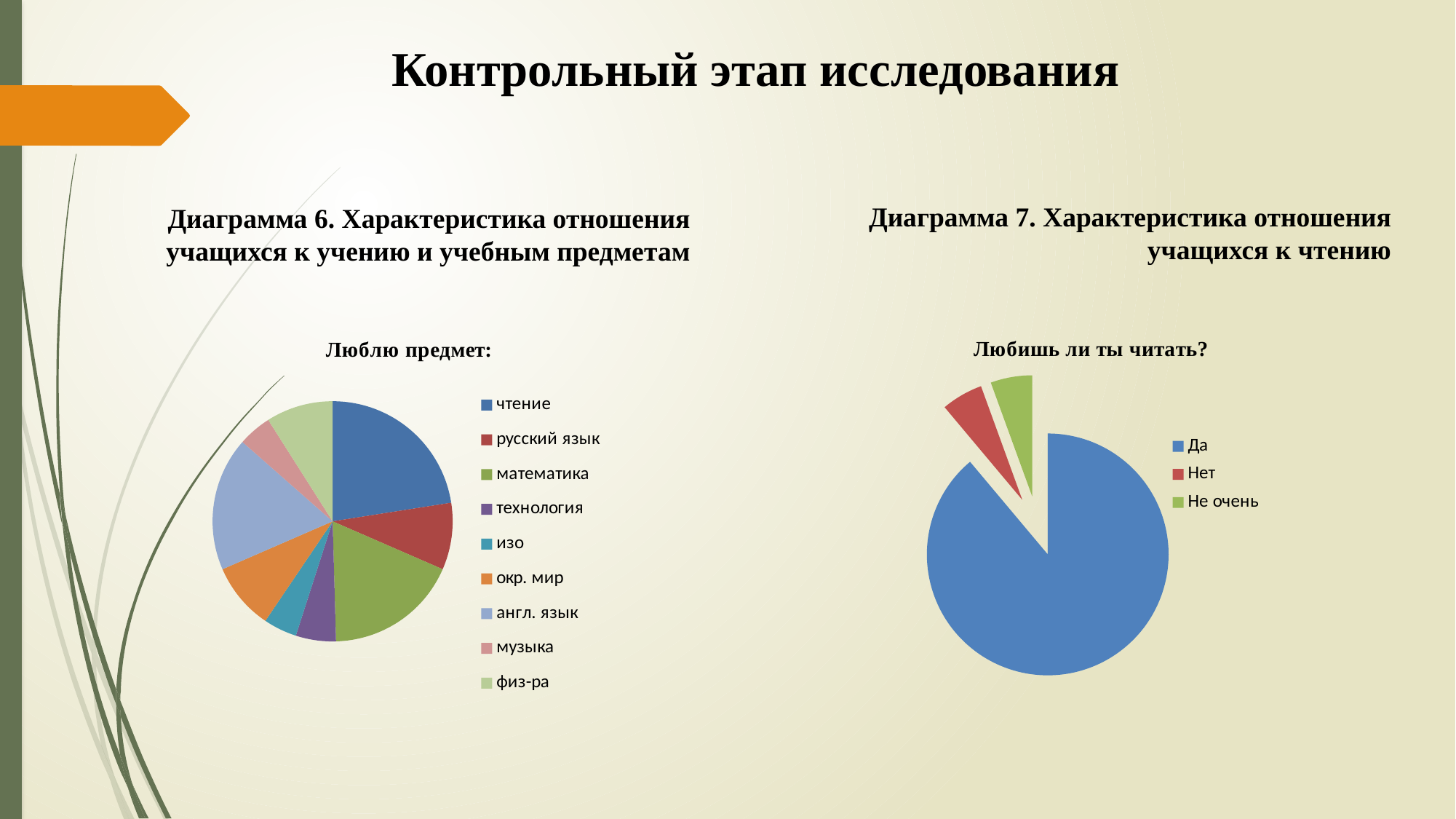
In the chart titled "Любишь ли ты читать?", how many categories does the legend list? 3 What kind of chart is the chart titled "Любишь ли ты читать?"? pie chart What is the title of the pie chart on the right side of the slide? Любишь ли ты читать? In the chart titled "Люблю предмет:", which slice is larger, чтение or русский язык? чтение In the chart titled "Люблю предмет:", which slice is larger, англ. язык or изо? англ. язык In the chart titled "Люблю предмет:", how many categories does the legend list? 9 In the chart titled "Любишь ли ты читать?", which slice is larger, Да or Нет? Да In the chart titled "Люблю предмет:", which category has the largest slice? чтение In the chart titled "Любишь ли ты читать?", which category has the largest slice? Да What kind of chart is the chart titled "Люблю предмет:"? pie chart In the chart titled "Любишь ли ты читать?", which category is shown in blue? Да